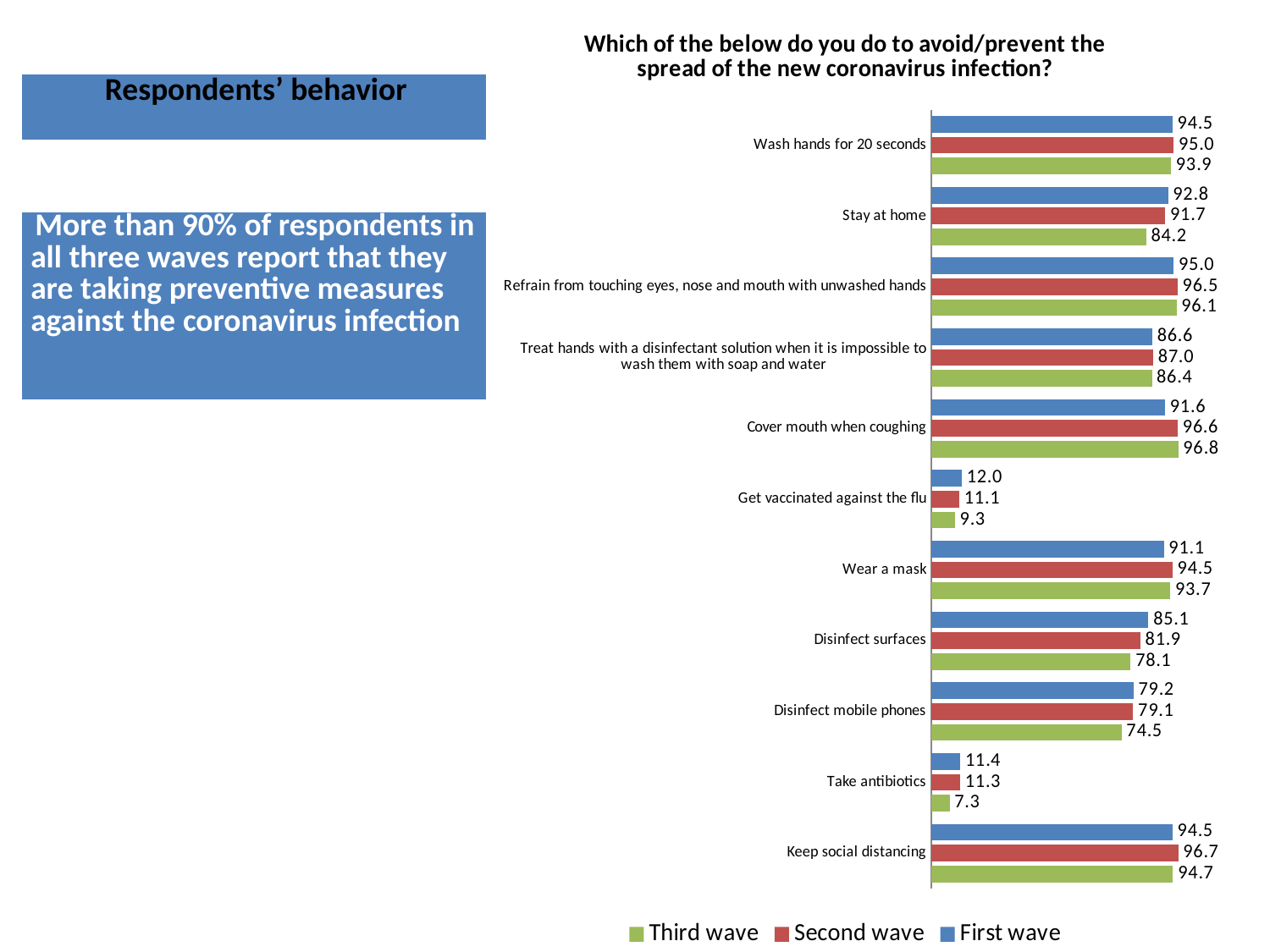
What is the First wave value for 'Stay at home'? 92.8 How many categories (preventive measures) are shown in the chart? 11 What is the difference between the First wave and Third wave values for 'Stay at home'? 8.6 What is the Third wave value for 'Get vaccinated against the flu'? 9.3 Which series is shown in green in the chart? Third wave Which category has the highest First wave value? Refrain from touching eyes, nose and mouth with unwashed hands What kind of chart is shown on the slide? Bar chart What is the Second wave value for 'Keep social distancing'? 96.7 Which category has the lowest Third wave value? Take antibiotics For 'Disinfect surfaces', which is larger: the First wave value or the Third wave value? First wave What is the difference between the First wave and Third wave values for 'Disinfect surfaces'? 7.0 How many series does the legend list? 3